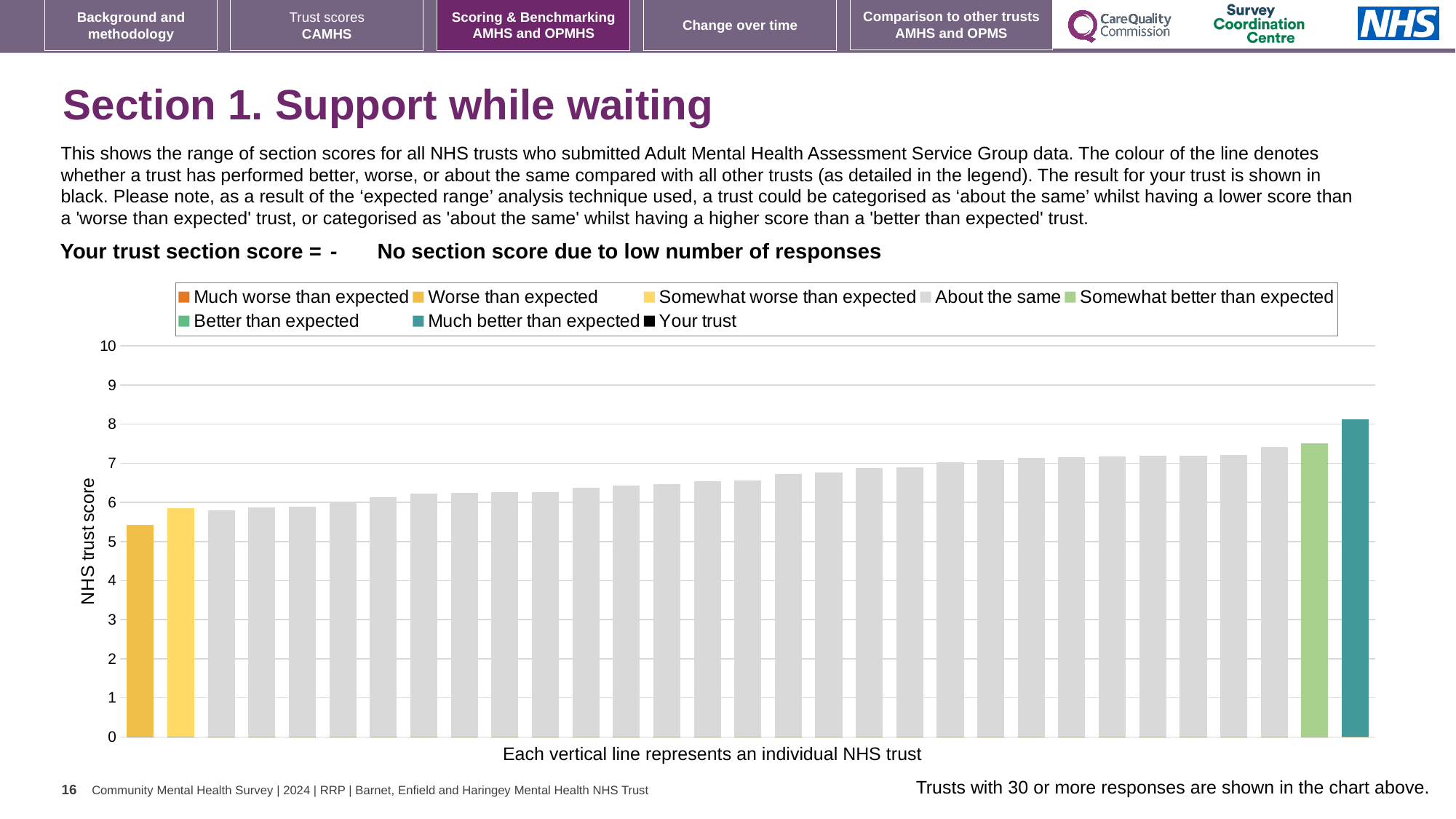
How many bars in the chart are coloured something other than grey? 4 What is the highest value shown on the vertical axis? 10 Is the value of the light green bar greater or less than 7? greater Do the bar values rise or fall from left to right across the chart? rise Is the value of the rightmost (teal) bar greater or less than 7? greater What kind of chart is shown on the slide? bar chart Which bar is taller, the leftmost bar or the rightmost bar? the rightmost bar How many entries does the chart legend list? 8 Is the value of the leftmost bar greater or less than 5? greater Which legend category does the tallest bar in the chart belong to? Much better than expected What is the label on the vertical axis of the chart? NHS trust score